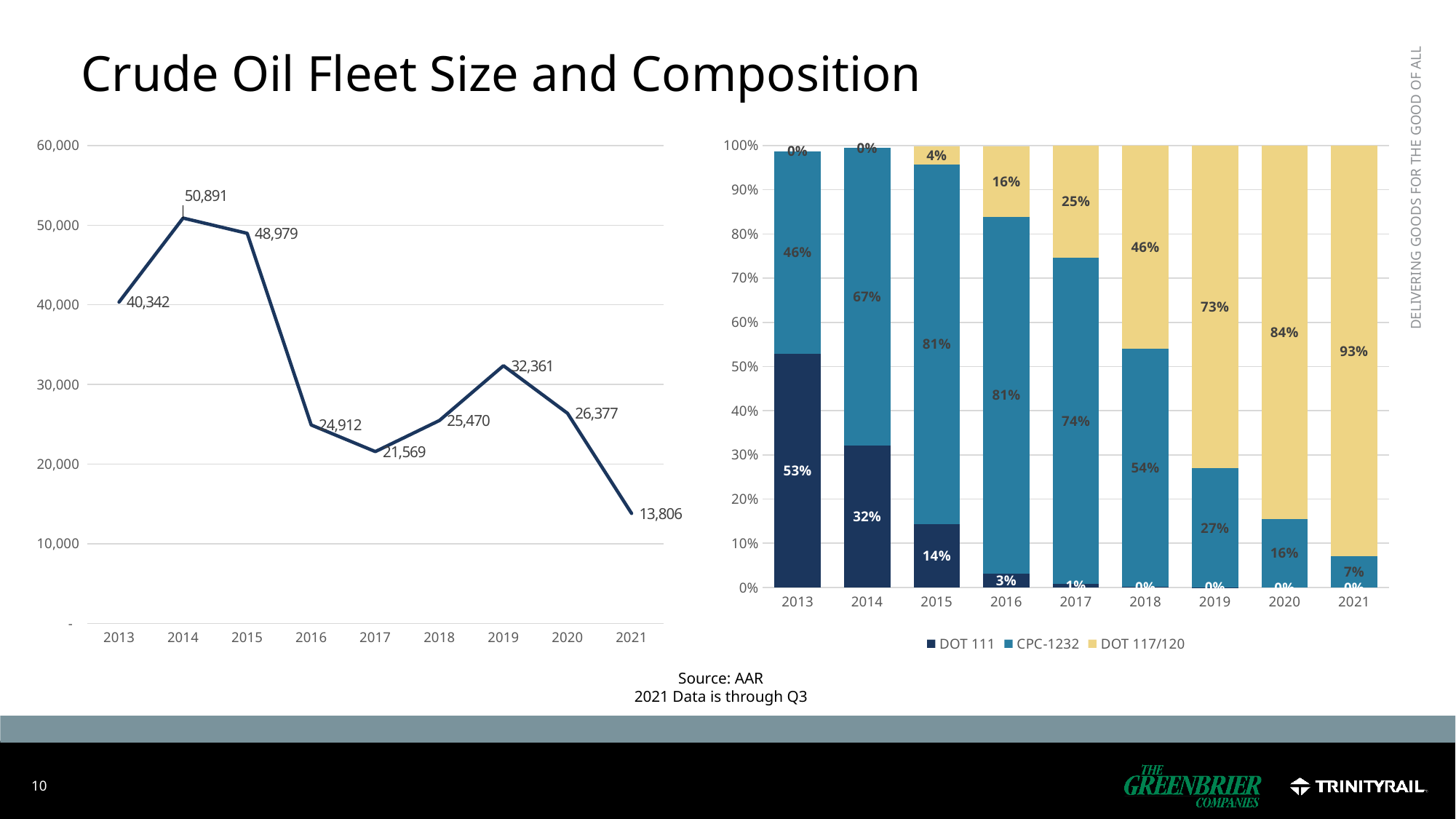
In the line chart on the left, what is the value for 2021? 13,806 What kind of chart is the chart on the left? line chart In the stacked bar chart on the right, what is the DOT 111 share for 2013? 53% In the stacked bar chart on the right, does the DOT 117/120 share rise or fall from 2015 to 2021? rise In the line chart on the left, which year has the lowest value? 2021 In the line chart on the left, what is the value for 2014? 50,891 In the line chart on the left, is the value for 2016 greater or less than 30,000? less In the stacked bar chart on the right, how many series does the legend list? 3 In the line chart on the left, how many years are plotted on the x axis? 9 In the line chart on the left, what is the difference between the 2019 value and the 2020 value? 5,984 In the stacked bar chart on the right, what is the DOT 117/120 share for 2019? 73% In the line chart on the left, which year has the highest value? 2014